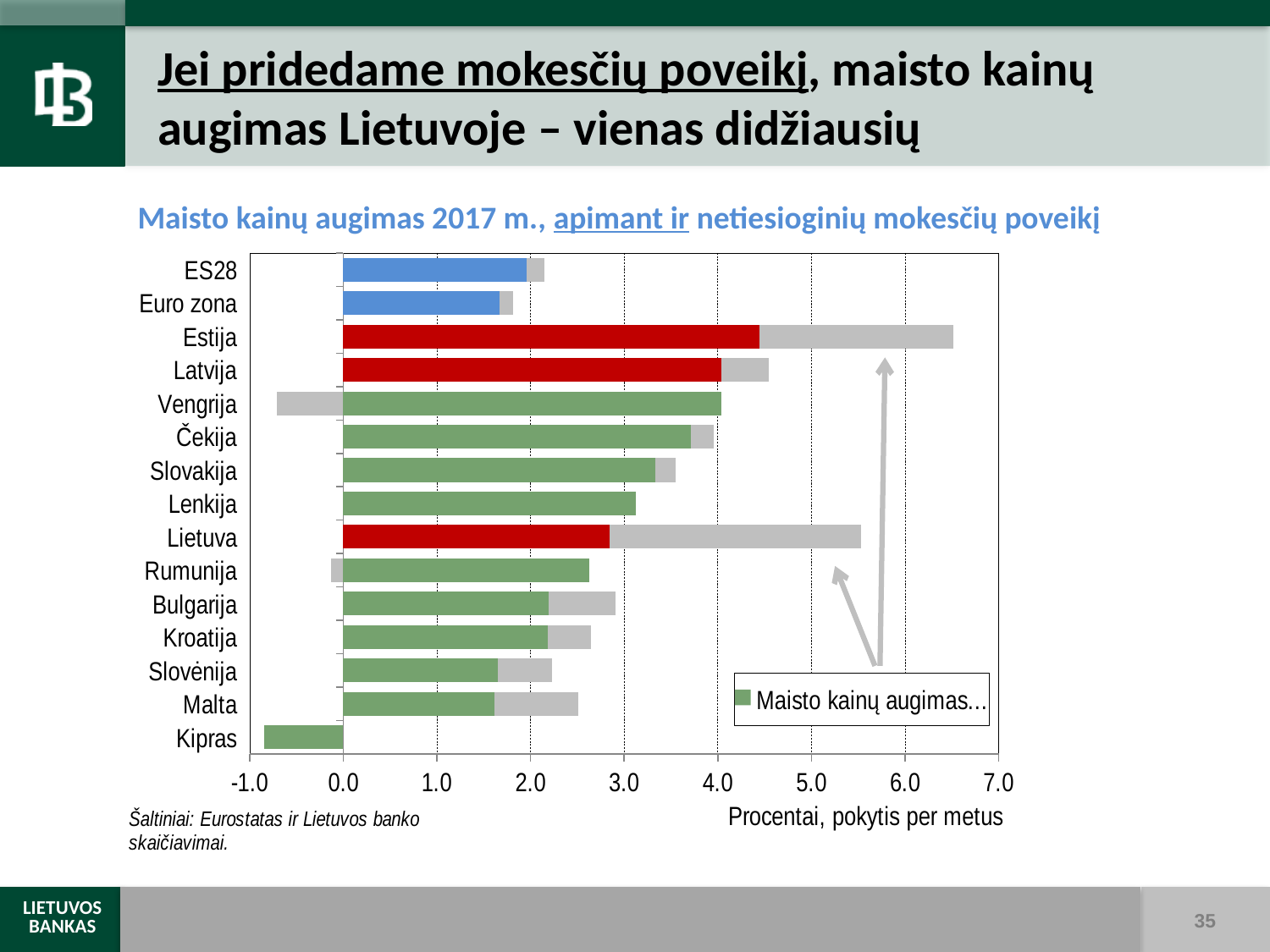
Which category has the lowest (negative) value in the chart? Kipras Is the value of the red bar for Estija greater or less than 4.0? greater Is the value of the red bar for Lietuva greater or less than 3.0? less What is the title of the chart? Maisto kainų augimas 2017 m., apimant ir netiesioginių mokesčių poveikį What kind of chart is shown on the slide? bar chart Is the value of the green bar for Malta greater or less than 2.0? less What is the label of the horizontal axis of the chart? Procentai, pokytis per metus How many categories (countries/regions) are listed on the vertical axis of the chart? 15 Which category has the longest total bar (including the grey segment) in the chart? Estija Which has the longer total bar (including the grey segment): Lietuva or Latvija? Lietuva